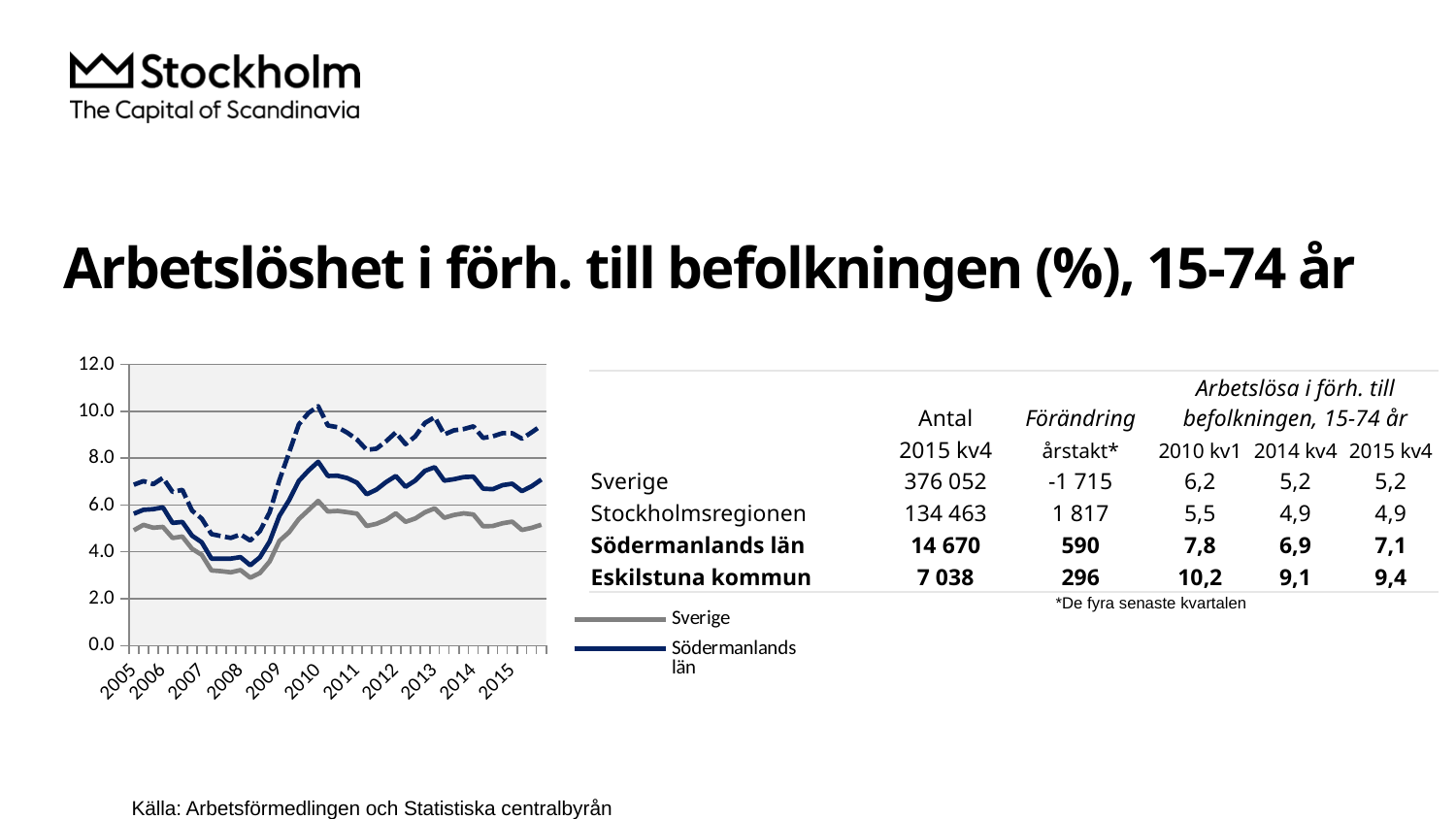
Do the values for Södermanlands län rise or fall between 2008 and 2010? rise Is the peak value for Södermanlands län around 2010 greater or less than 6.0? greater What is the highest value shown on the chart's y axis? 12.0 Is the value for Sverige in 2008 greater or less than 4.0? less What kind of chart is shown on the slide? line chart Which series is plotted with a grey line? Sverige How many year labels are shown on the chart's x axis? 11 Is the value for Södermanlands län in 2015 greater or less than 6.0? greater Do the values for Sverige rise or fall between 2007 and 2008? fall Which series is higher in 2010, Sverige or Södermanlands län? Södermanlands län How many series does the chart legend list? 2